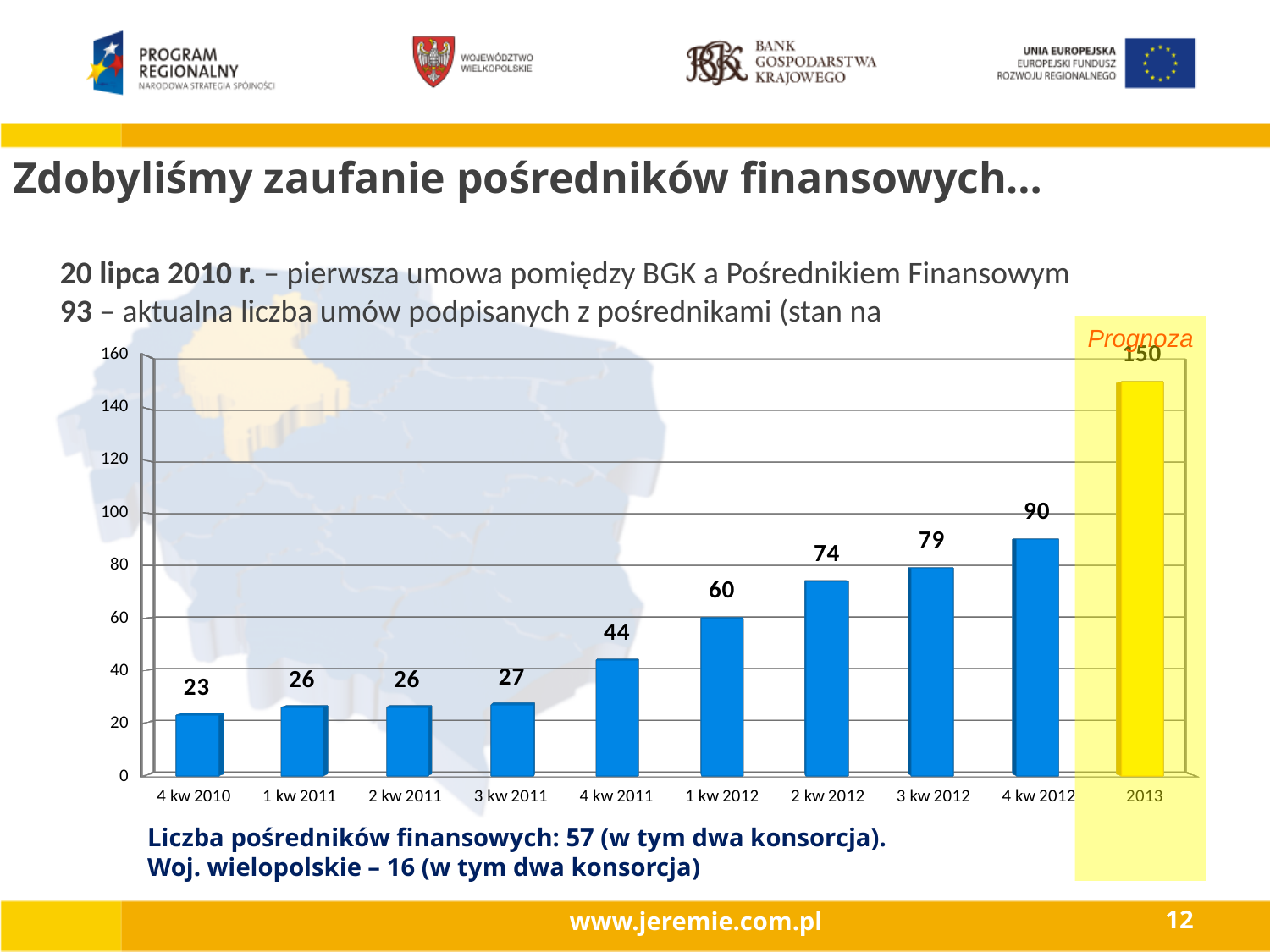
Is the value for 4 kw 2012 greater or less than 100? less What kind of chart is shown on the slide? bar chart What is the difference between the values for 1 kw 2012 and 4 kw 2011? 16 What is the value for 4 kw 2011? 44 What is the value for 2 kw 2012? 74 Which is larger, the value for 3 kw 2011 or the value for 4 kw 2011? 4 kw 2011 Which category has the lowest value? 4 kw 2010 What is the value shown for 2013? 150 How many categories are shown on the x axis? 10 What is the difference between the values for 4 kw 2012 and 3 kw 2012? 11 Do the values rise or fall from 4 kw 2010 to 4 kw 2012? rise Which category has the highest value? 2013